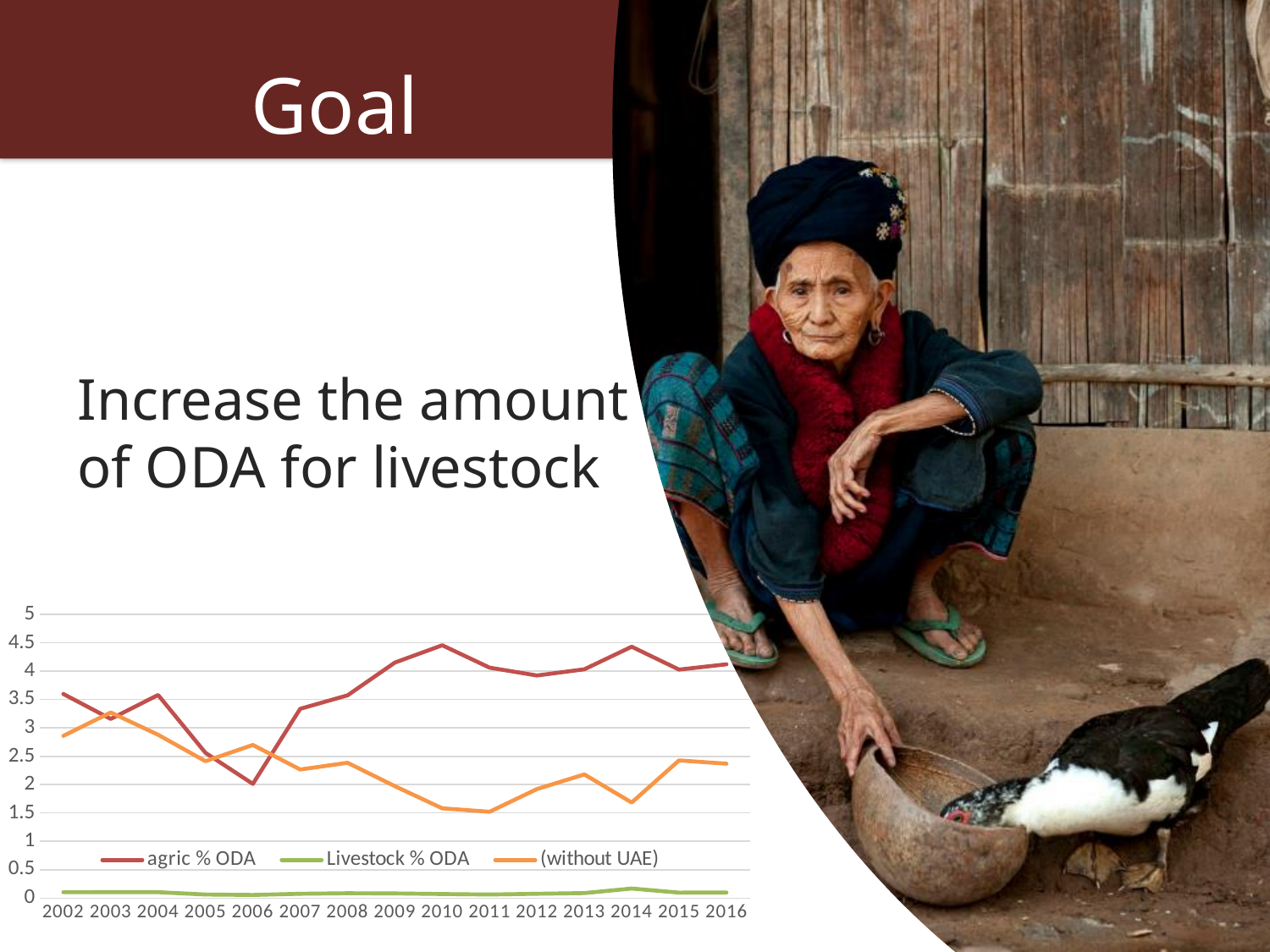
Is the agric % ODA value for 2010 greater or less than 4? greater Is the (without UAE) value for 2011 greater or less than 2? less What kind of chart is shown on the slide? line chart In which year is the agric % ODA line at its lowest? 2006 In which year is the (without UAE) line at its highest? 2003 In 2010, which series has the larger value: agric % ODA or (without UAE)? agric % ODA How many series does the chart's legend list? 3 Which series is shown in green in the chart? Livestock % ODA Is the agric % ODA value for 2006 greater or less than 2.5? less Does the agric % ODA line rise or fall between 2006 and 2010? rise How many years are plotted along the x axis of the chart? 15